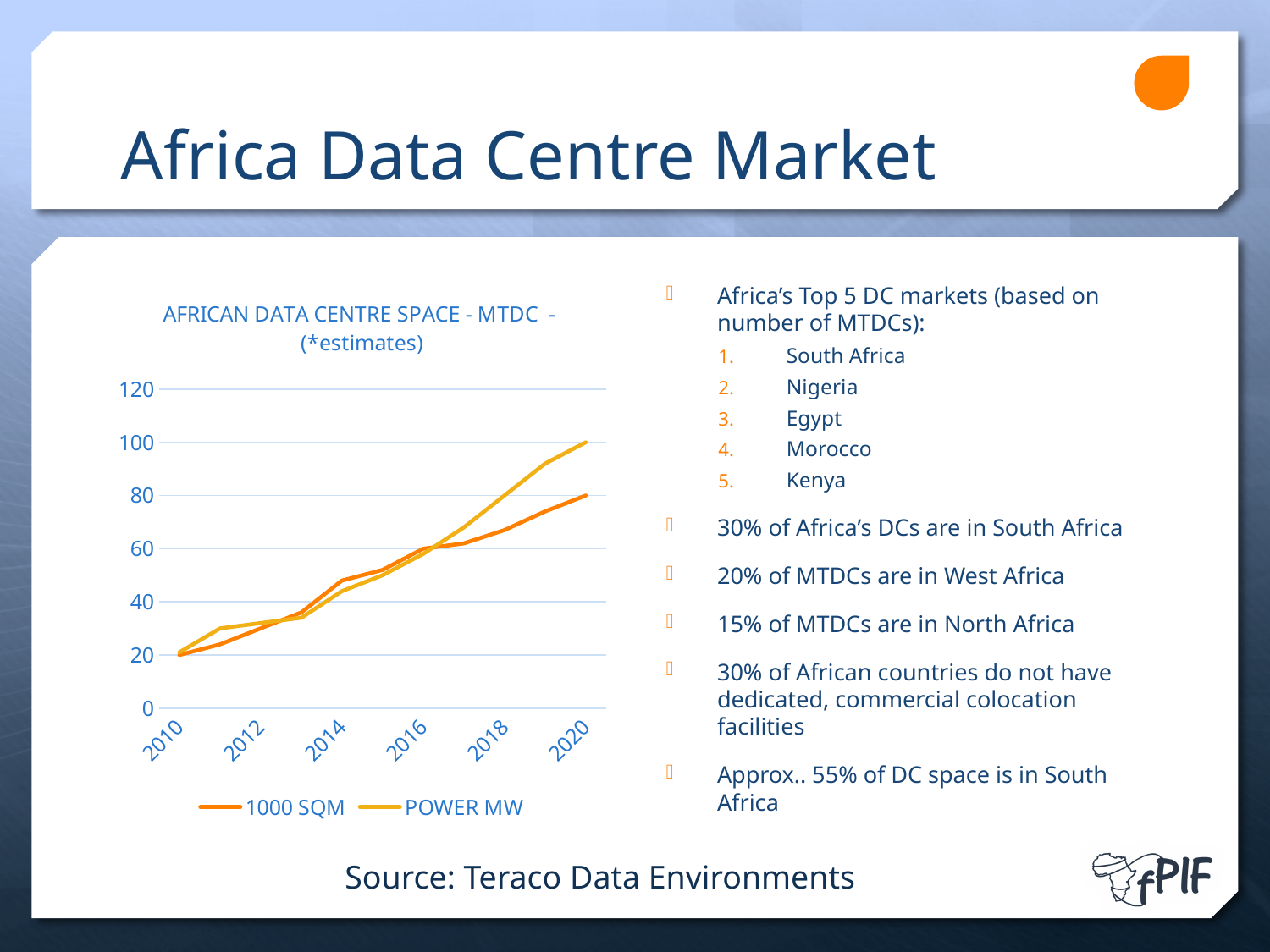
In which year does the POWER MW series reach its highest value? 2020 Is the value of 1000 SQM in 2020 greater or less than 100? less How many series does the chart legend list? 2 Is the value of POWER MW in 2020 greater or less than 80? greater Is the value of POWER MW in 2018 greater or less than 60? greater What kind of chart is shown on the slide? line chart Does the POWER MW series rise or fall from 2010 to 2020? rise Does the 1000 SQM series rise or fall from 2010 to 2020? rise What is the title of the chart? AFRICAN DATA CENTRE SPACE - MTDC - (*estimates) In 2020, which series has the higher value, 1000 SQM or POWER MW? POWER MW What are the two series named in the chart legend? 1000 SQM and POWER MW